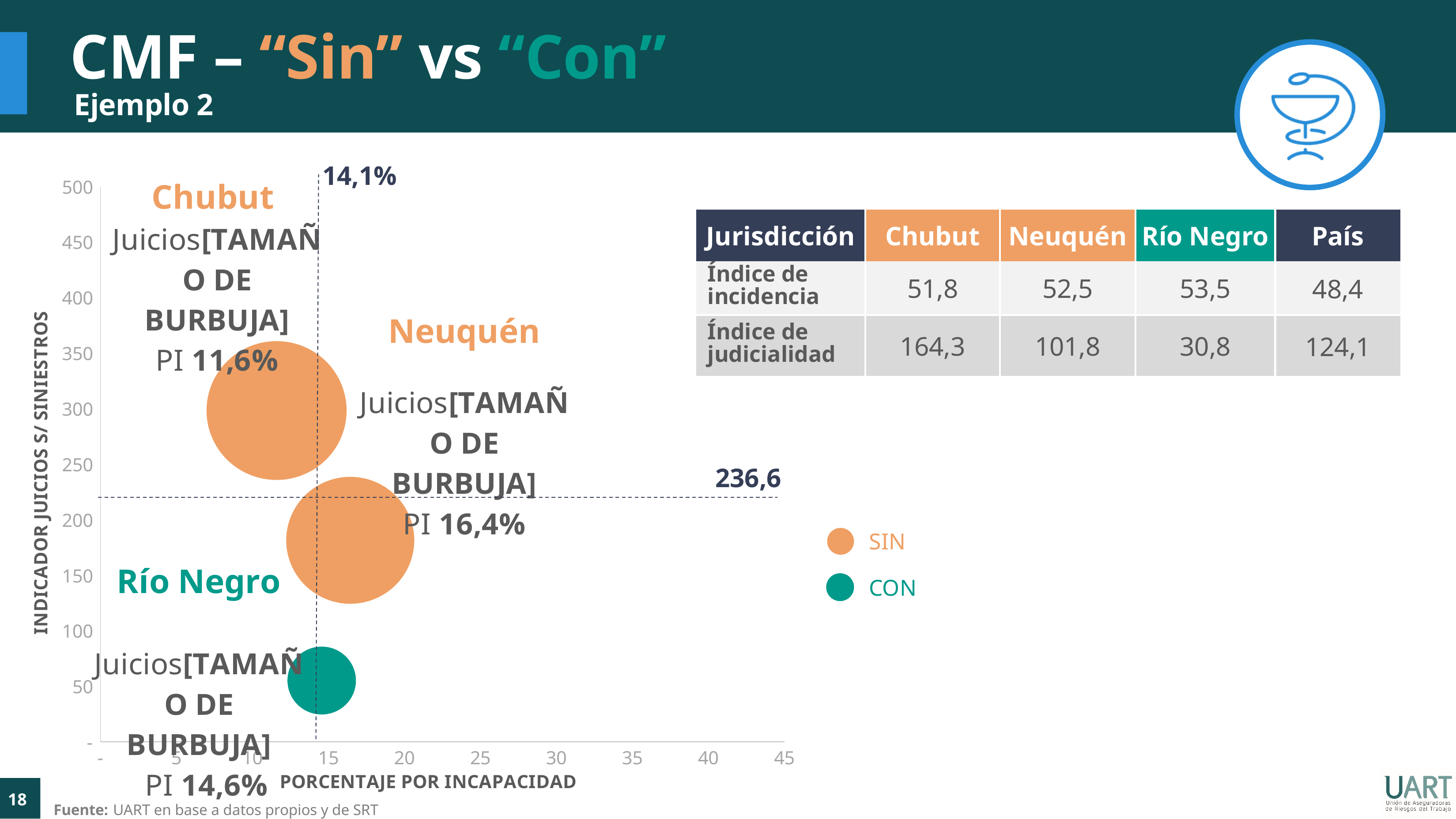
Which jurisdiction has the highest labelled PI value? Neuquén Is the Indicador Juicios s/ Siniestros value for Chubut greater or less than 250? greater What is the PI value labelled for Río Negro? 14,6% Which jurisdiction has the lowest labelled PI value? Chubut Is the Indicador Juicios s/ Siniestros value for Río Negro greater or less than 100? less What is the PI (porcentaje por incapacidad) value labelled for Chubut? 11,6% What kind of chart is shown on the slide? Bubble chart How many bubbles (jurisdictions) are plotted on the chart? 3 What is the PI value labelled for Neuquén? 16,4% What is the difference between the PI values of Neuquén and Chubut? 4,8 percentage points How many series does the chart legend list? 2 What value is labelled on the horizontal dashed reference line of the chart? 236,6